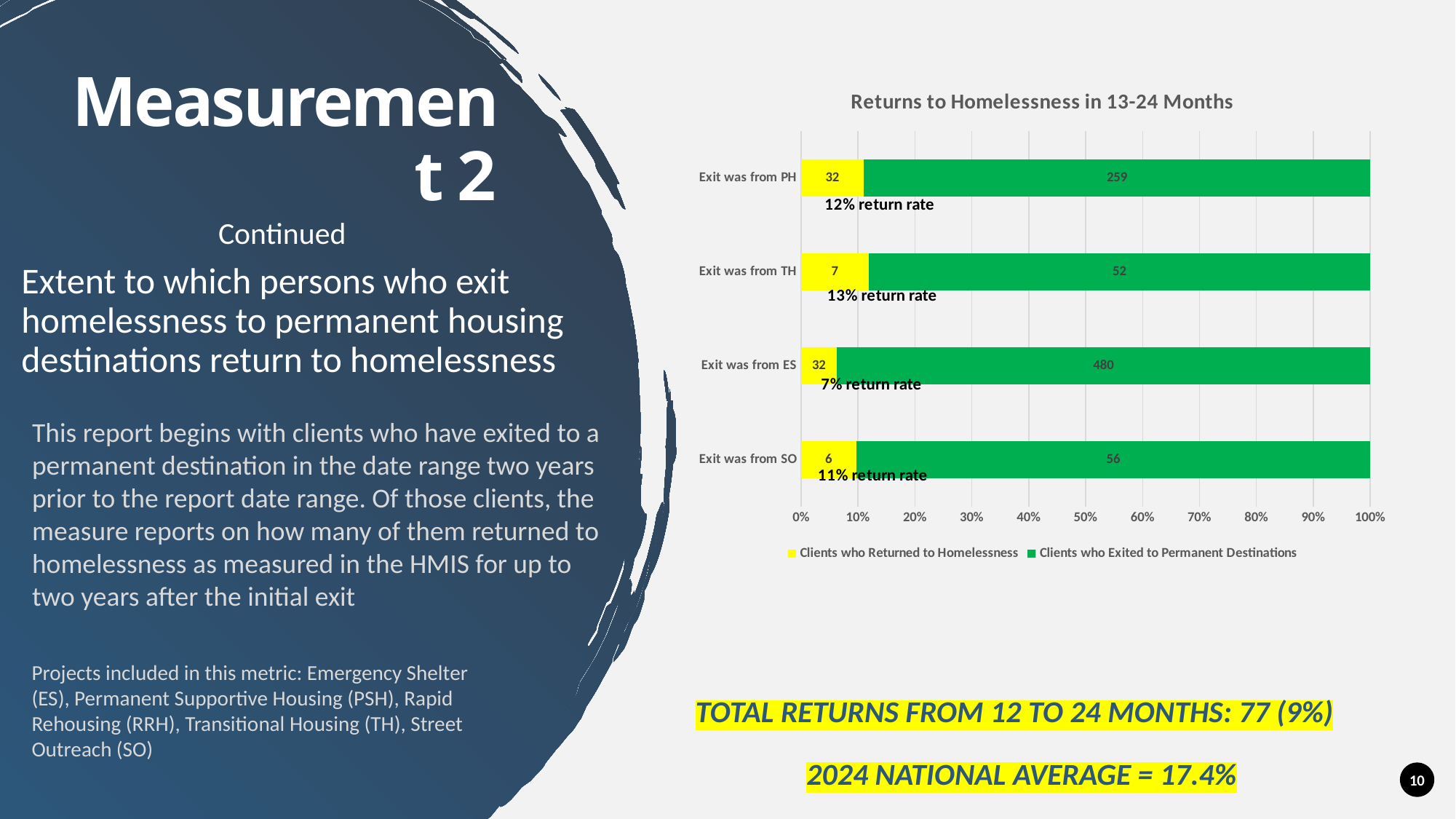
How many categories are shown on the chart? 4 Which category has the lowest number of clients who returned to homelessness? Exit was from SO What is the return rate shown for exits from TH? 13% return rate What is the title of the chart? Returns to Homelessness in 13-24 Months What is the difference between the number of clients who exited to permanent destinations from PH and from TH? 207 What type of chart is shown on the slide? Stacked bar chart How many clients who exited from SO returned to homelessness? 6 How many series does the chart legend list? 2 What is the total number of clients in the 'Exit was from TH' bar? 59 Which category has the highest number of clients who exited to permanent destinations? Exit was from ES How many clients who exited from ES exited to permanent destinations? 480 How many clients who exited from PH returned to homelessness? 32